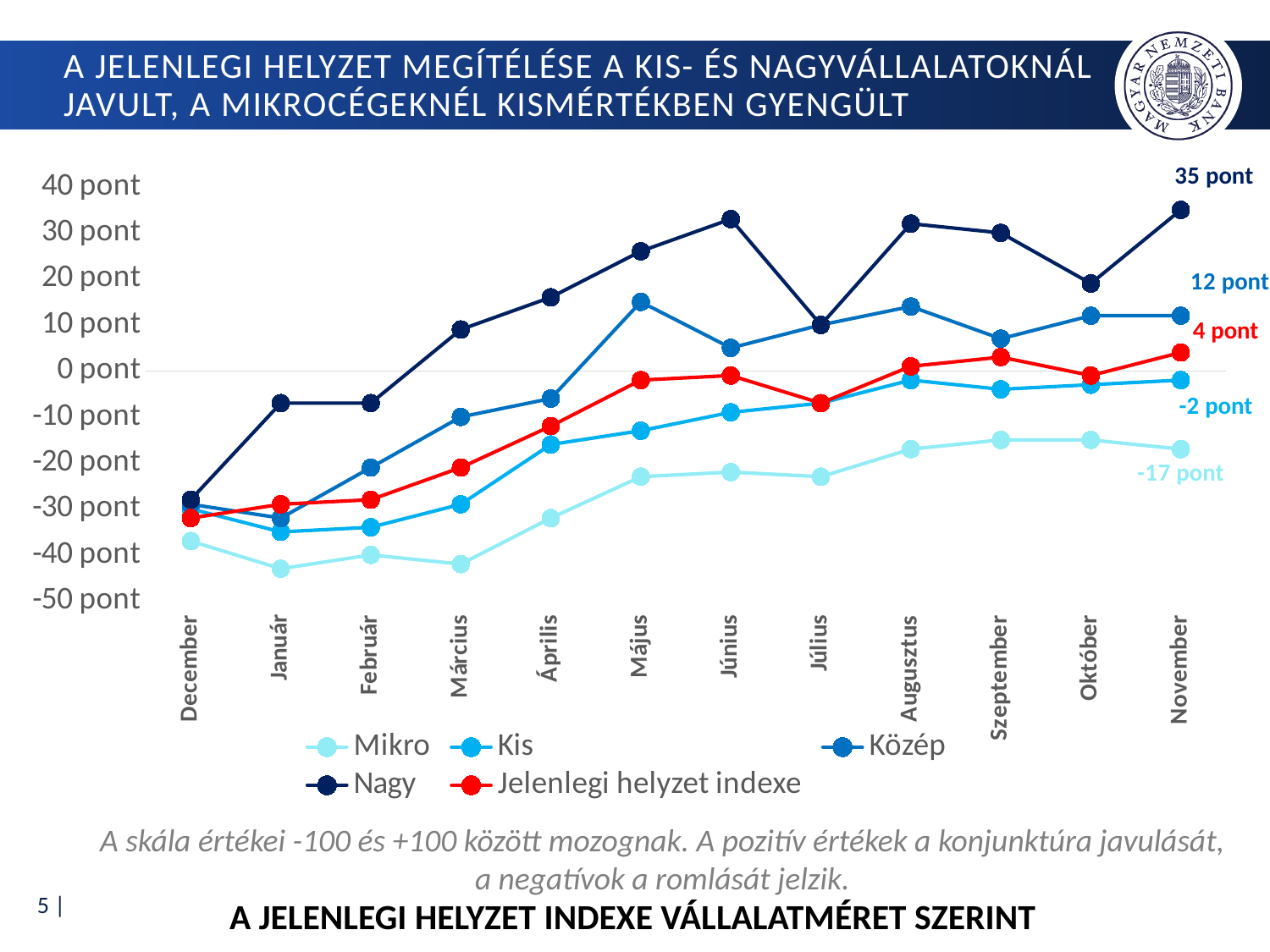
What is the value of the Közép series in November? 12 pont What is the value of the Jelenlegi helyzet indexe series in November? 4 pont What is the value of the Nagy series in November? 35 pont What is the difference between the Nagy and Közép values in November? 23 pont How many series does the legend list? 5 Which series has the highest value in November? Nagy How many months are shown on the x axis? 12 What is the value of the Mikro series in November? -17 pont Is the value of the Mikro series in January greater or less than -30 pont? less Which series has the lowest value in November? Mikro In June, which is higher: the Nagy series or the Közép series? Nagy What kind of chart is shown on the slide? line chart